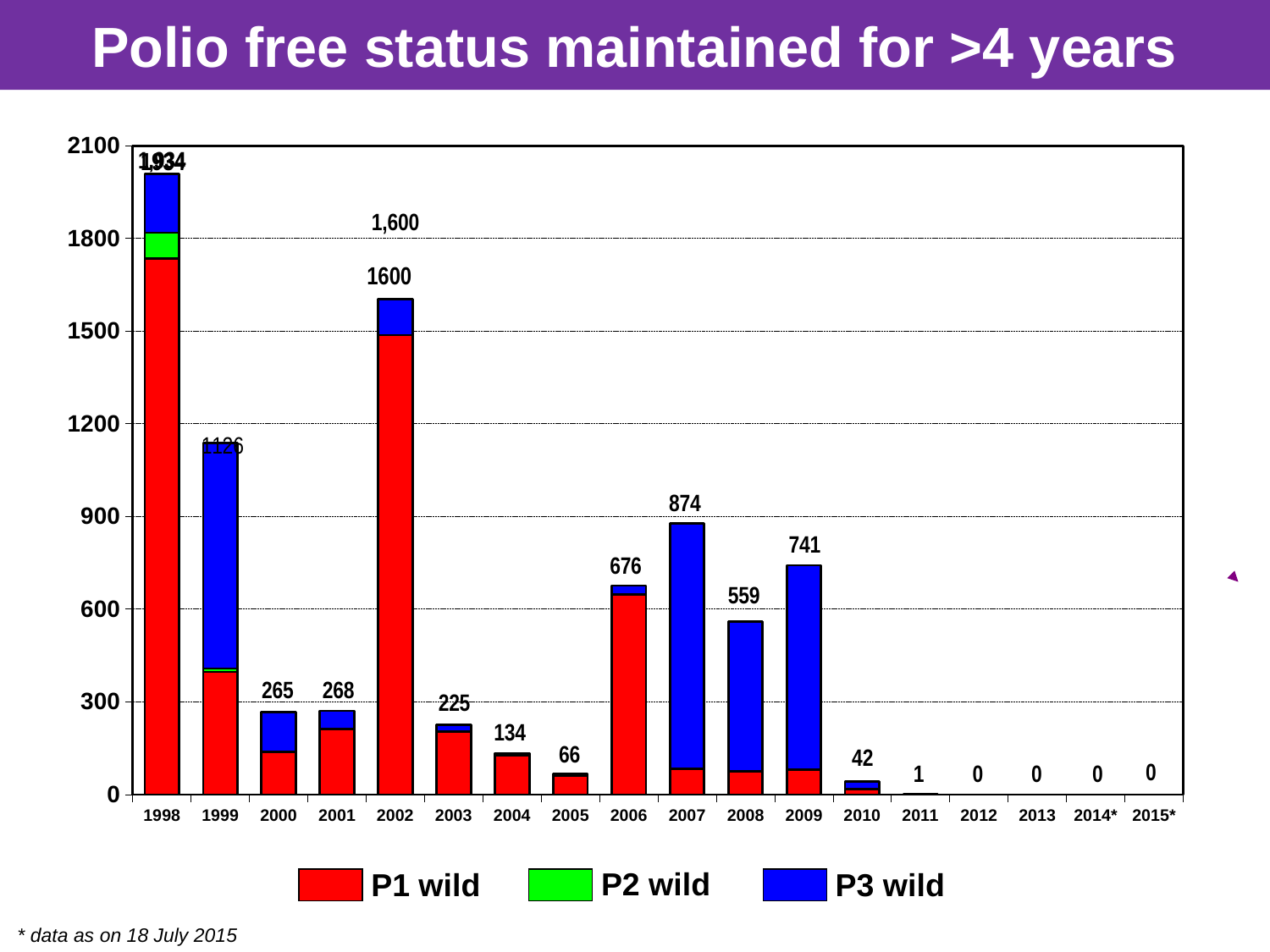
What is the difference between the totals for 2007 and 2008? 315 Which year has the larger total, 2007 or 2009? 2007 How many years are shown on the x axis? 18 What is the total value shown for 2007? 874 What is the total value shown for 2005? 66 How many series does the legend list? 3 Is the total value for 2006 greater or less than 600? greater Which series is shown in blue in the legend? P3 wild What is the total value shown for 2010? 42 What is the difference between the totals for 2003 and 2004? 91 Which year has the highest total bar? 1998 What kind of chart is shown on the slide? Stacked bar chart